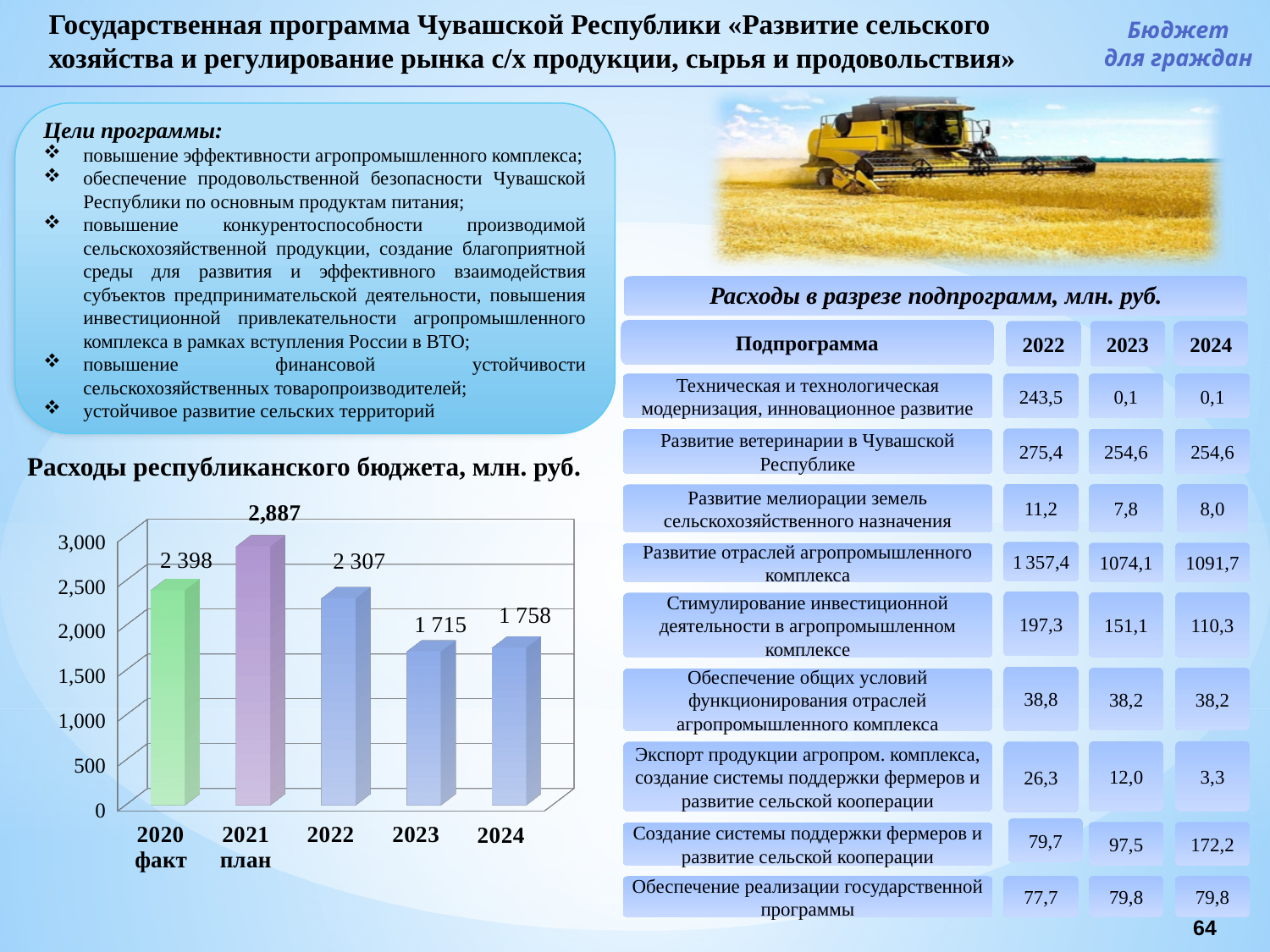
In the chart 'Расходы республиканского бюджета, млн. руб.', what is the value for 2021 план? 2,887 In the chart 'Расходы республиканского бюджета, млн. руб.', what is the value for 2023? 1 715 In the chart 'Расходы республиканского бюджета, млн. руб.', which year has the lowest value? 2023 In the chart 'Расходы республиканского бюджета, млн. руб.', what is the value for 2020 факт? 2 398 What type of chart is used to show 'Расходы республиканского бюджета, млн. руб.'? bar chart In the chart 'Расходы республиканского бюджета, млн. руб.', which is larger: the value for 2020 факт or the value for 2022? 2020 факт In the chart 'Расходы республиканского бюджета, млн. руб.', what is the value for 2024? 1 758 In the chart 'Расходы республиканского бюджета, млн. руб.', what is the difference between the values for 2021 план and 2020 факт? 489 In the chart 'Расходы республиканского бюджета, млн. руб.', is the value for 2024 greater or less than 2,000? less In the chart 'Расходы республиканского бюджета, млн. руб.', which year has the highest value? 2021 план How many bars are shown in the chart 'Расходы республиканского бюджета, млн. руб.'? 5 In the chart 'Расходы республиканского бюджета, млн. руб.', what is the difference between the values for 2022 and 2023? 592